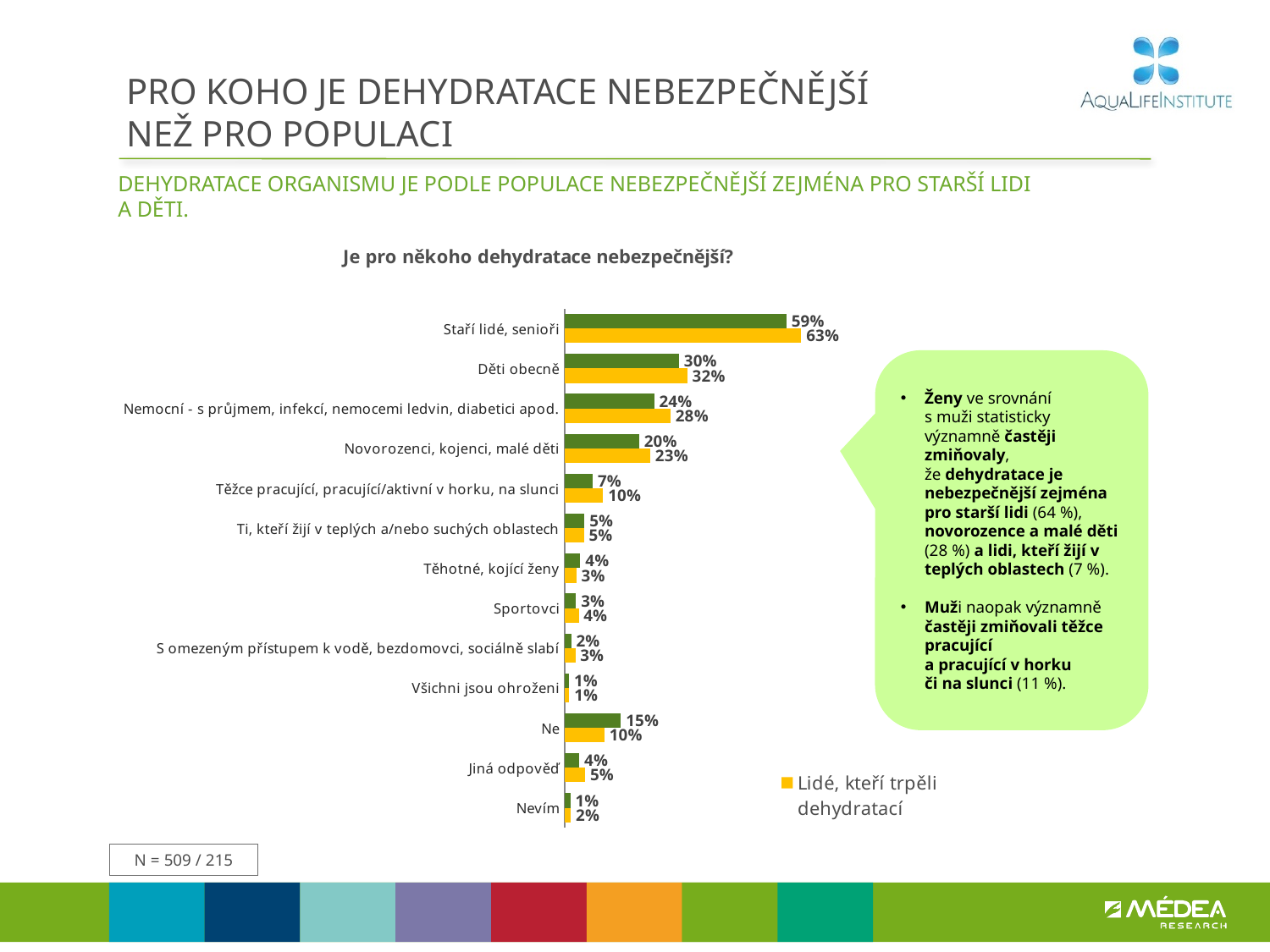
How many series does the chart legend list? 1 What is the value for 'Novorozenci, kojenci, malé děti' in the series 'Lidé, kteří trpěli dehydratací'? 23% How many categories are shown on the chart? 13 What type of chart is shown on the slide? bar chart Which category has the highest value in the series 'Lidé, kteří trpěli dehydratací'? Staří lidé, senioři What is the title of the chart? Je pro někoho dehydratace nebezpečnější? What is the value of the green bar for 'Děti obecně'? 30% What is the difference between the yellow and green bars for 'Staří lidé, senioři'? 4% What is the difference between the green and yellow bars for 'Ne'? 5% What is the value of the green bar for 'Ne'? 15% For 'Těžce pracující, pracující/aktivní v horku, na slunci', which is larger: the green bar or the yellow bar? the yellow bar What is the value for 'Staří lidé, senioři' in the series 'Lidé, kteří trpěli dehydratací'? 63%